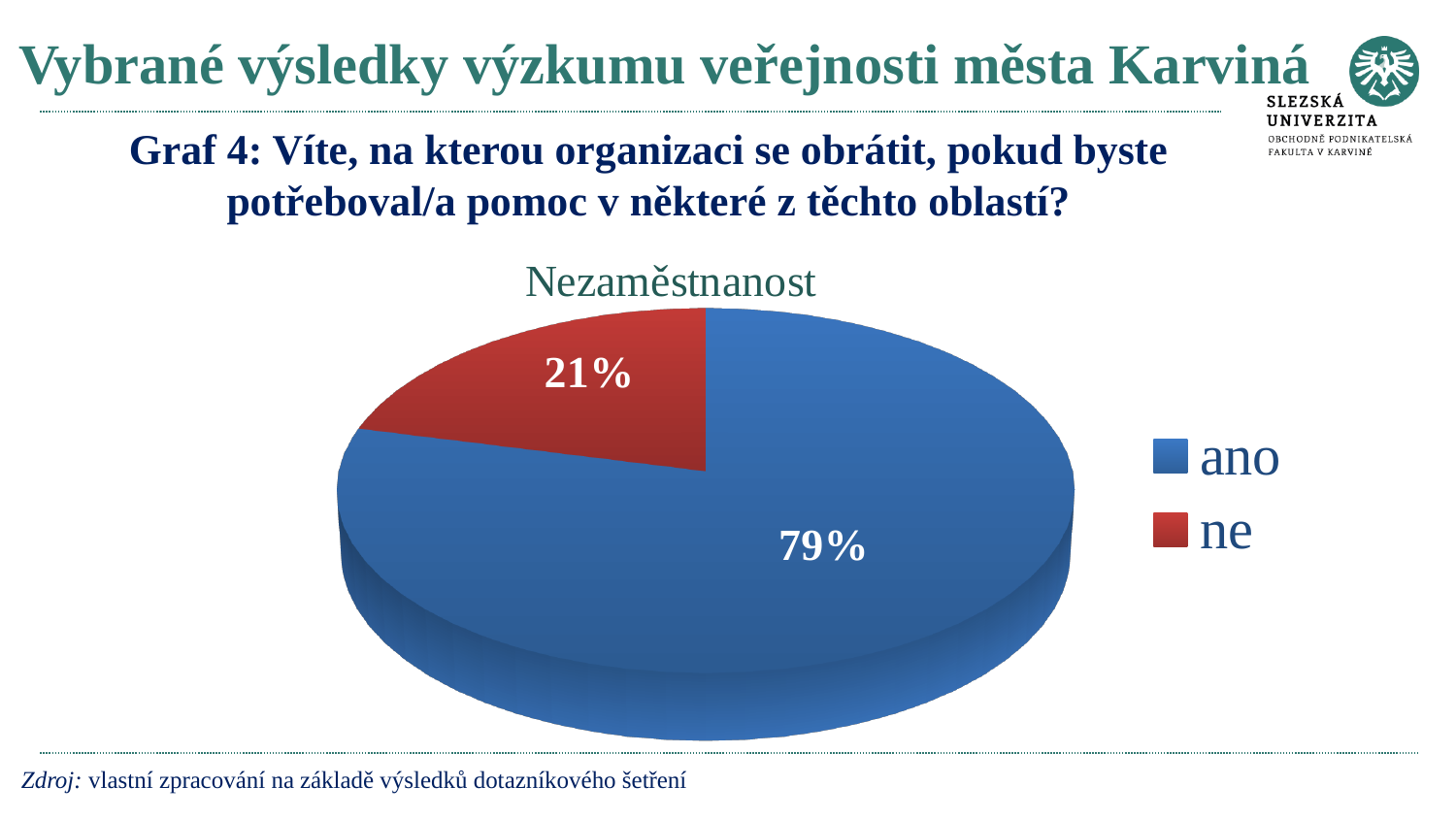
What share of the pie does the "ne" slice represent? 21% What percentage of the pie chart is labelled "ne"? 21% Which is larger, the "ano" slice or the "ne" slice? ano What is the difference in percentage points between the "ano" and "ne" slices? 58 What is the title of the pie chart? Nezaměstnanost What percentage of the pie chart is labelled "ano"? 79% Which slice of the pie chart is the smallest? ne What kind of chart is shown on the slide? pie chart Which slice of the pie chart is the largest? ano What colour is the "ne" slice in the pie chart? red How many entries does the legend list? 2 How many slices does the pie chart have? 2